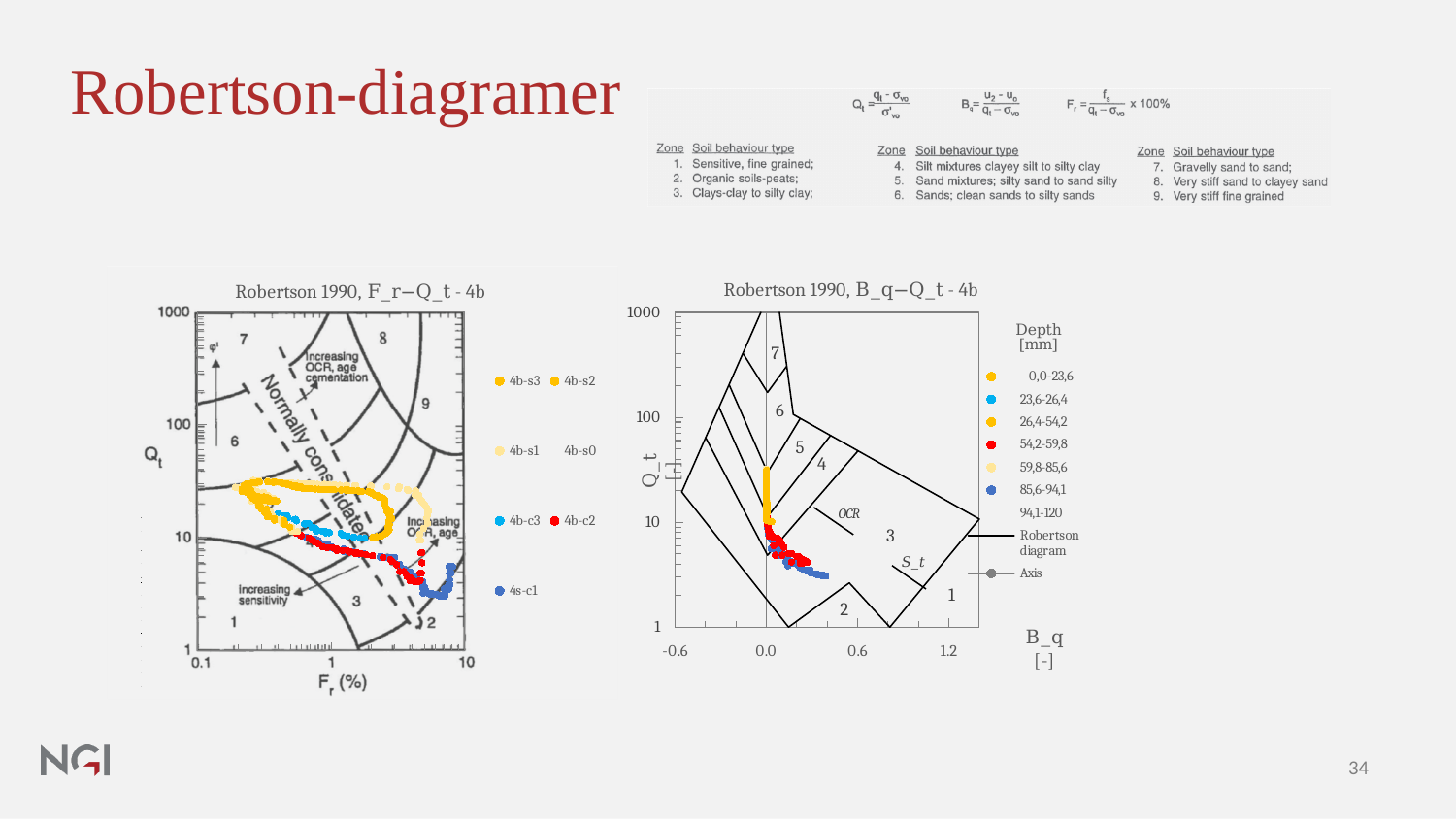
What kind of chart is the chart titled "Robertson 1990, B_q–Q_t - 4b"? scatter chart How many series does the legend of the chart titled "Robertson 1990, F_r–Q_t - 4b" list? 7 In the chart titled "Robertson 1990, B_q–Q_t - 4b", what is the title of the legend? Depth [mm] In the chart titled "Robertson 1990, F_r–Q_t - 4b", are the F_r values of the 4s-c1 points greater or less than 1? greater How many depth ranges does the legend of the chart titled "Robertson 1990, B_q–Q_t - 4b" list? 7 In the chart titled "Robertson 1990, B_q–Q_t - 4b", what is the label of the x axis? B_q [-] What kind of chart is the chart titled "Robertson 1990, F_r–Q_t - 4b"? scatter chart